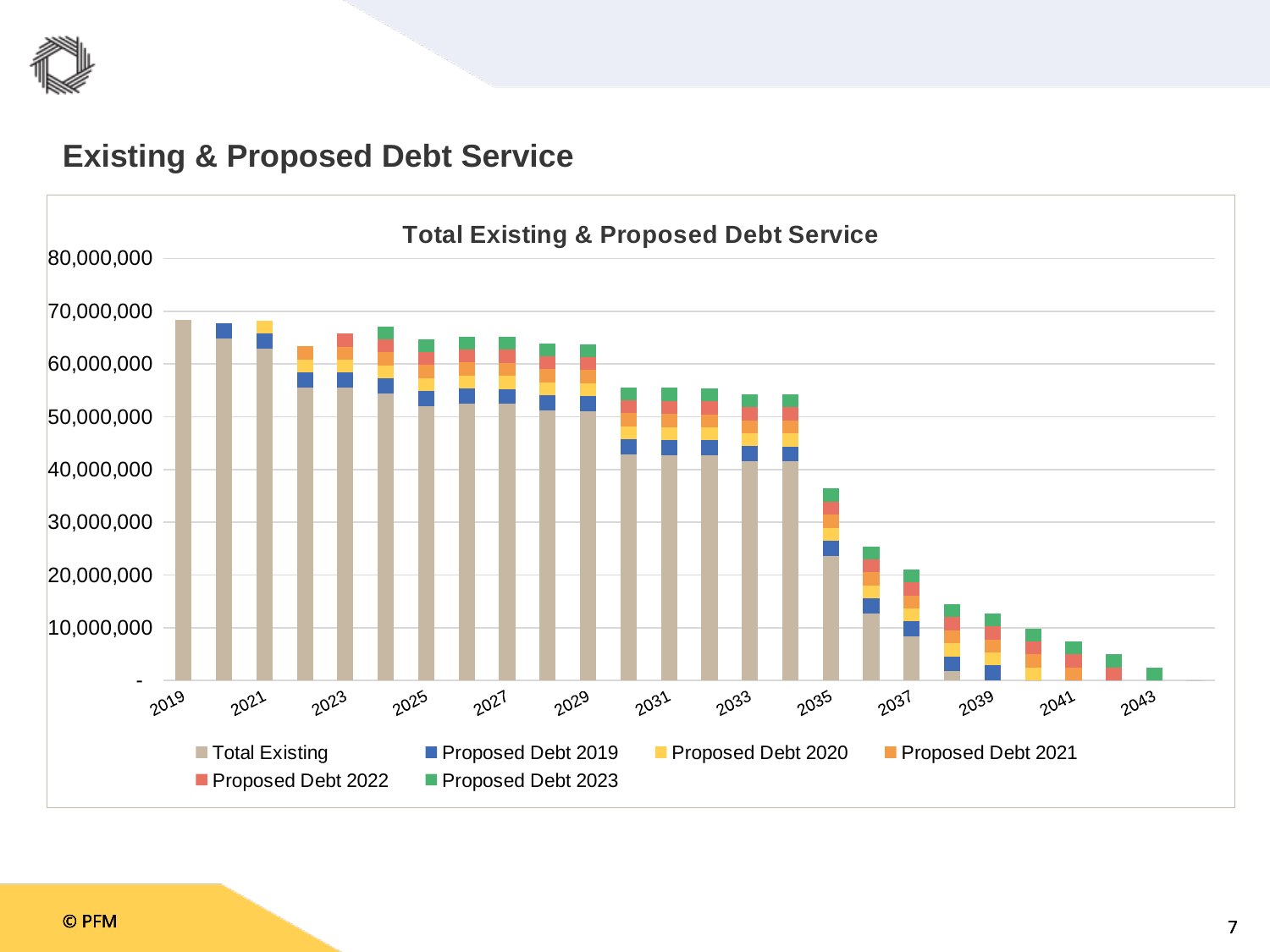
Which year has the lowest total debt service? 2043 Is the total debt service for 2019 greater or less than 60,000,000? greater What kind of chart is shown on the slide? Stacked bar chart How many years (bars) are plotted on the chart? 25 How many series does the legend list? 6 What is the title of the chart? Total Existing & Proposed Debt Service Is the total debt service for 2043 greater or less than 10,000,000? less Which year has the larger total debt service, 2029 or 2031? 2029 Which series is shown in green in the legend? Proposed Debt 2023 Is the total debt service for 2035 greater or less than 40,000,000? less Do the total debt service values generally rise or fall from 2019 to 2043? Fall